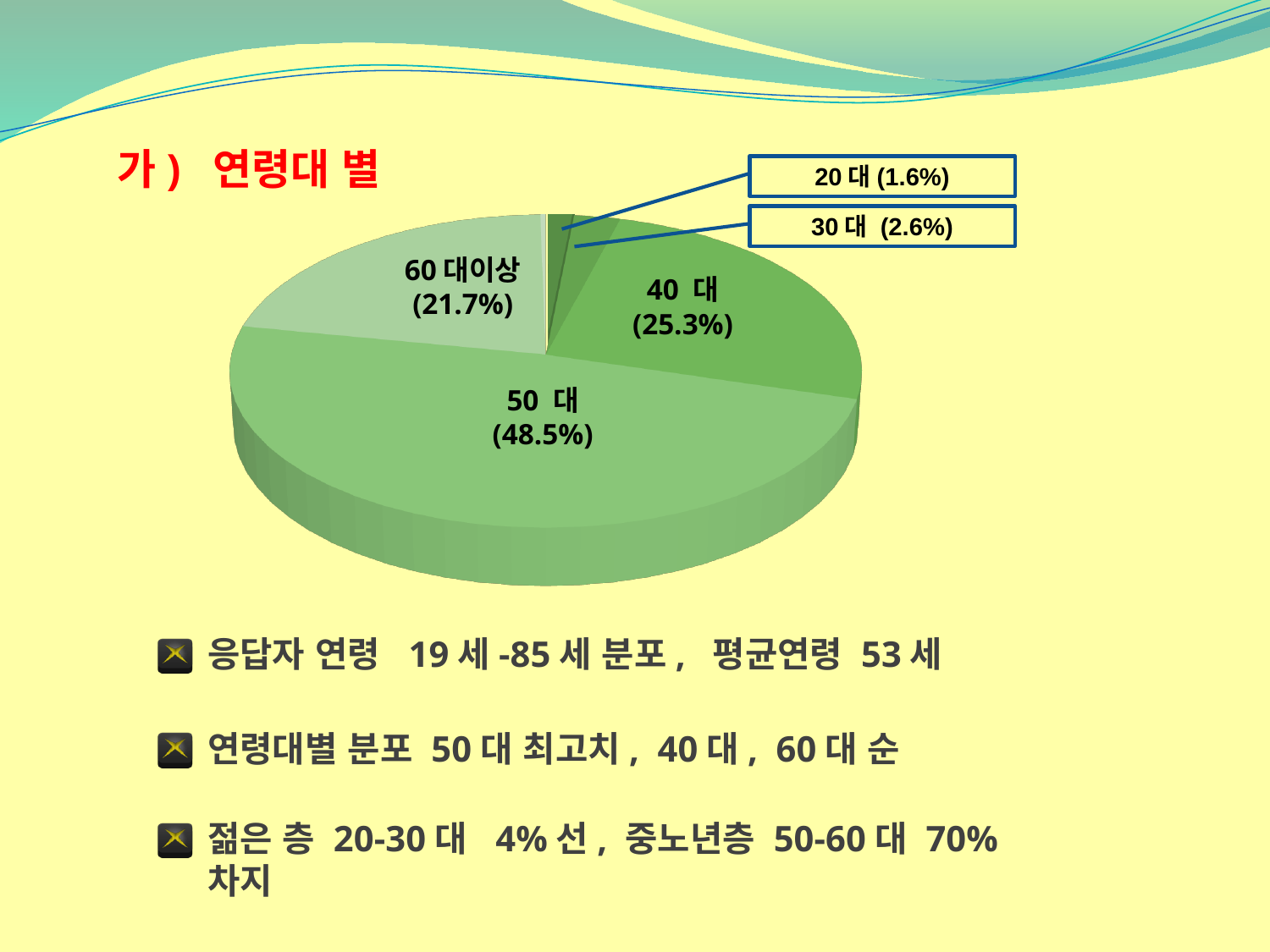
Which age group has the smallest slice of the pie? 20대 What is the value shown for 20대? 1.6% What is the difference in percentage points between the 50대 and 40대 slices? 23.2 What is the value shown for 30대? 2.6% Which age group has the largest slice of the pie? 50대 Which is larger, the 40대 slice or the 60대이상 slice? 40대 What share of the pie does the 50대 slice represent? 48.5% What type of chart is shown on the slide? pie chart What is the value shown for 40대? 25.3% What is the value shown for 60대이상? 21.7% What is the title of the chart section on the slide? 가) 연령대 별